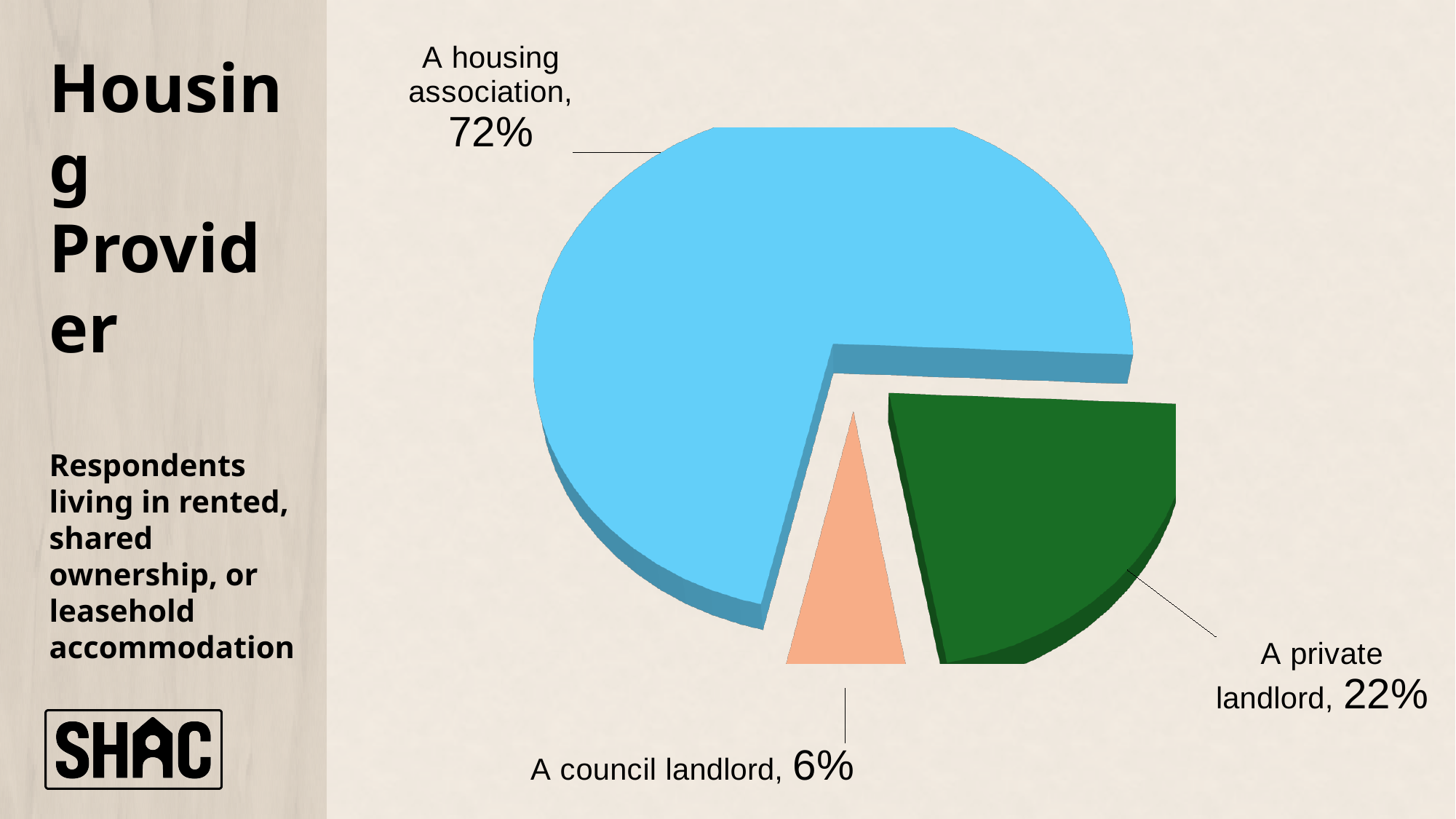
What colour is the slice for a private landlord? Green What kind of chart is shown on the slide? Pie chart Which is larger: the share for a private landlord or the share for a council landlord? A private landlord What share of respondents have a council landlord? 6% What is the title of the slide containing the chart? Housing Provider What share of respondents have a private landlord? 22% Which housing provider has the smallest share of respondents? A council landlord What is the difference in percentage points between the housing association share and the private landlord share? 50 How many housing provider categories are shown in the pie chart? 3 What share of respondents have a housing association as their housing provider? 72% What is the difference in percentage points between the private landlord share and the council landlord share? 16 Which housing provider has the largest share of respondents? A housing association